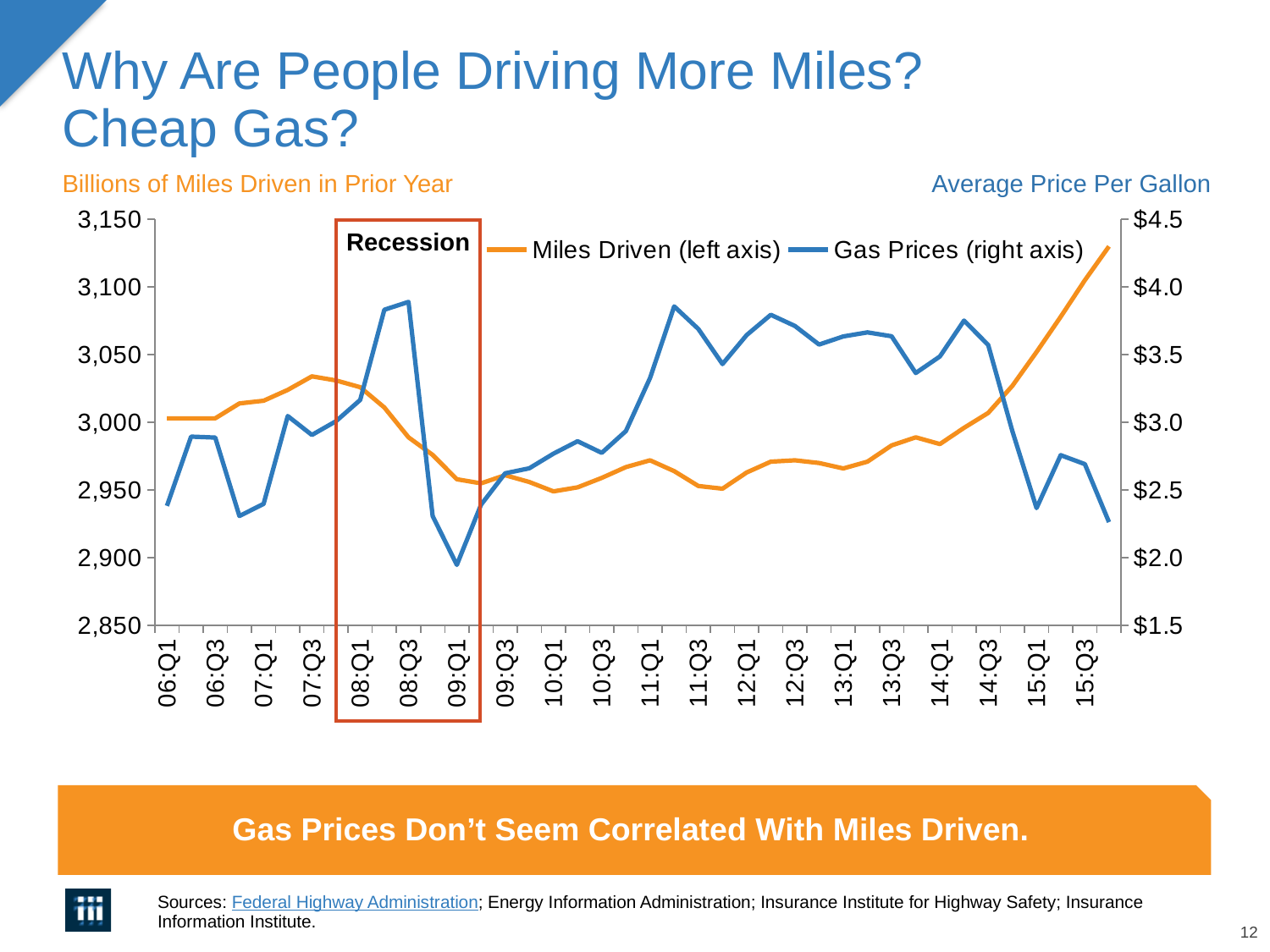
How many series does the legend list? 2 What kind of chart is shown on the slide? Line chart At which quarter is the Gas Prices series at its lowest? 09:Q1 Does the Miles Driven series rise or fall from 14:Q1 to 15:Q4? Rise Which is larger, the Gas Prices value at 08:Q3 or at 09:Q1? 08:Q3 Is the Gas Prices value at 08:Q3 greater or less than $3.5? greater Is the Miles Driven value at 15:Q3 greater or less than 3,050? greater Is the Gas Prices value at 15:Q1 greater or less than $3.0? less At which quarter is the Miles Driven series at its highest? 15:Q4 What period is marked by the red box on the chart? Recession Which series is plotted against the right axis? Gas Prices